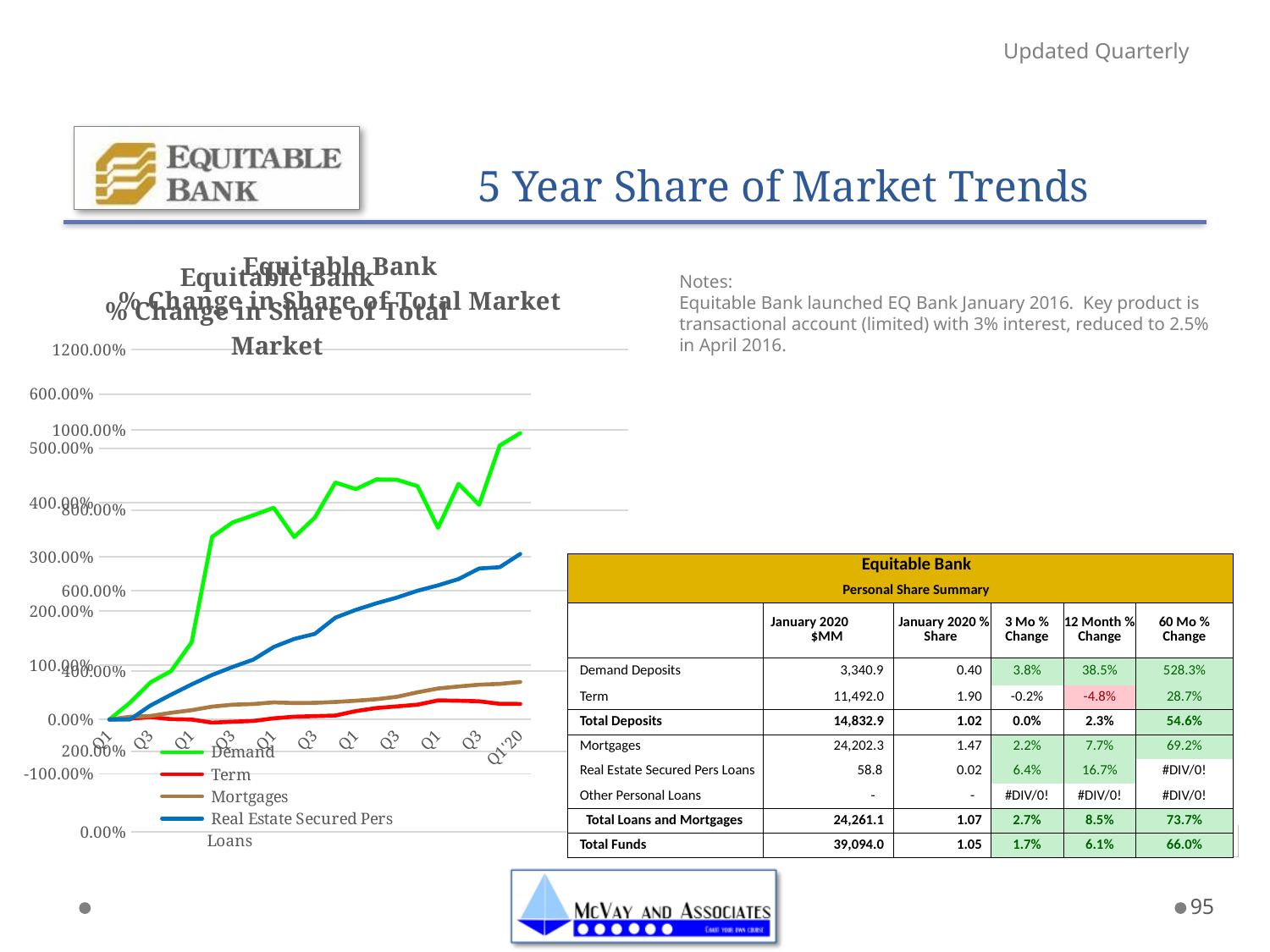
Which series is highest at the final point (Q1'20) on the chart? Demand What colour is the Demand line on the chart? green At the final point (Q1'20), which is larger: Real Estate Secured Pers Loans or Mortgages? Real Estate Secured Pers Loans At the final point (Q1'20), which is larger: Mortgages or Term? Mortgages Which series is drawn in red on the chart? Term Does the Demand line generally rise or fall from left to right? rise Does the Real Estate Secured Pers Loans line generally rise or fall from left to right? rise Which series is lowest at the final point (Q1'20) on the chart? Term What kind of chart is shown on the slide? line chart How many series does the chart's legend list? 4 At the final point (Q1'20), which is larger: Demand or Term? Demand